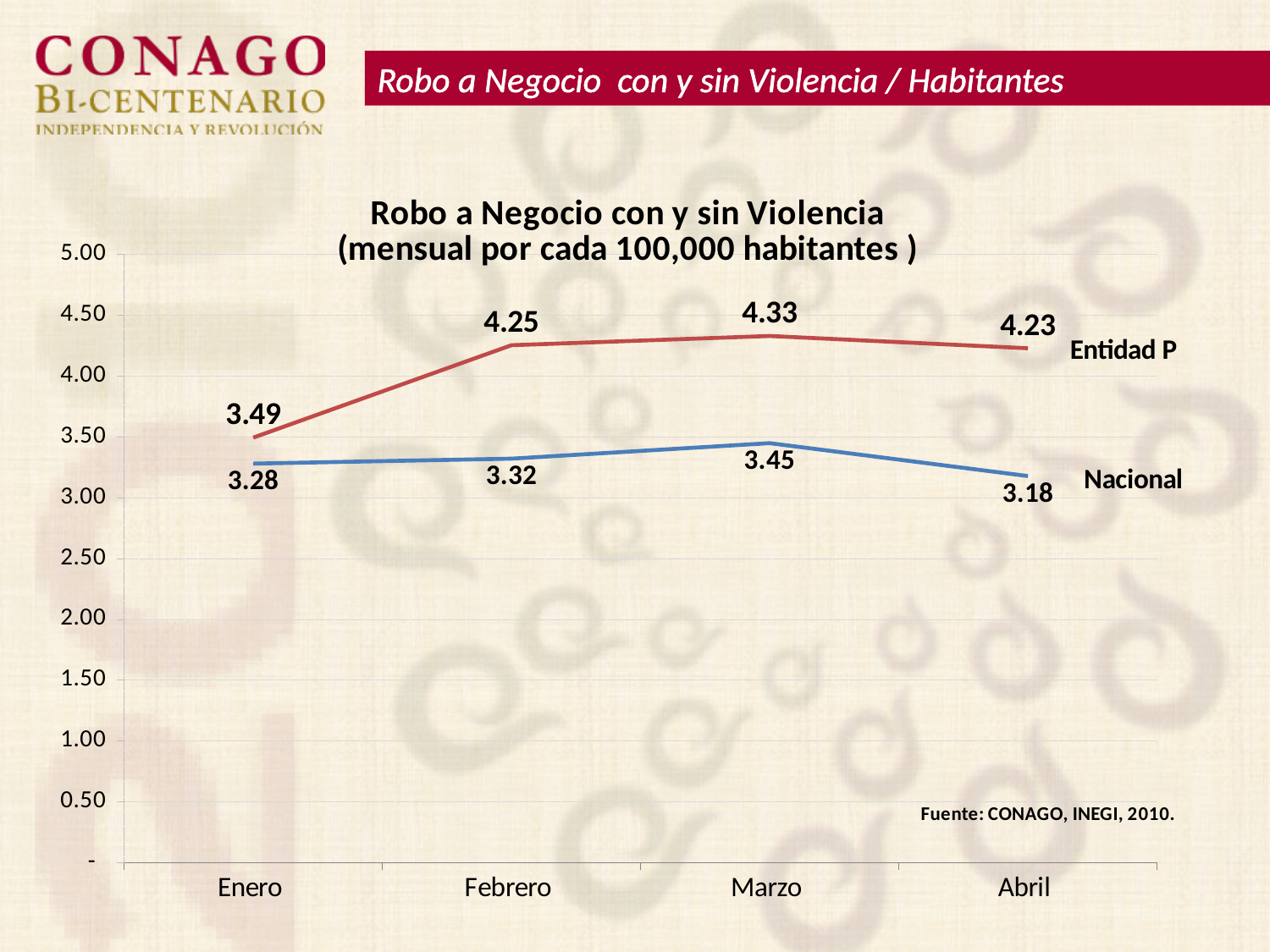
Which is larger in Abril, Entidad P or Nacional? Entidad P What is the value for Nacional in Abril? 3.18 What kind of chart is shown? line chart What is the value for Entidad P in Enero? 3.49 How many months are shown on the x axis? 4 How many series are plotted on the chart? 2 What is the value for Entidad P in Marzo? 4.33 Is the value for Entidad P in Febrero greater or less than 4.00? greater In which month is the Entidad P series lowest? Enero What is the source cited on the chart? CONAGO, INEGI, 2010. In which month is the Nacional series highest? Marzo What is the difference between Entidad P and Nacional in Febrero? 0.93